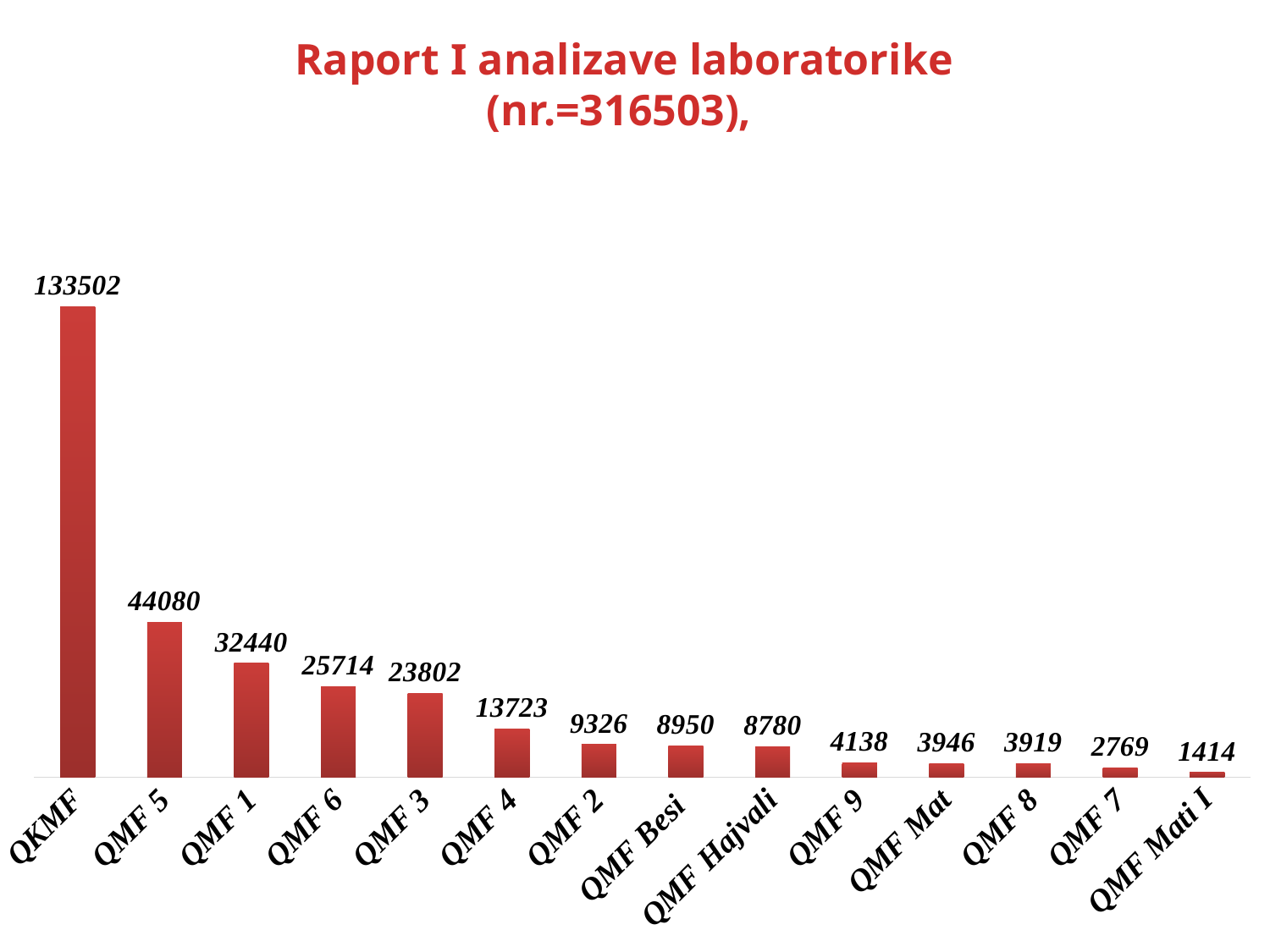
Which category has the highest value? QKMF What is the value for QMF Mat? 3946 What is the difference between the values for QMF 5 and QMF 1? 11640 What is the value for QKMF? 133502 Which is larger, the value for QMF Besi or the value for QMF 9? QMF Besi How many categories are shown on the x axis? 14 Which category has the lowest value? QMF Mati I What kind of chart is shown on the slide? bar chart What is the title of the chart? Raport I analizave laboratorike (nr.=316503), What is the value for QMF Hajvali? 8780 Which is larger, the value for QMF 4 or the value for QMF 2? QMF 4 What is the difference between the values for QMF 6 and QMF 3? 1912